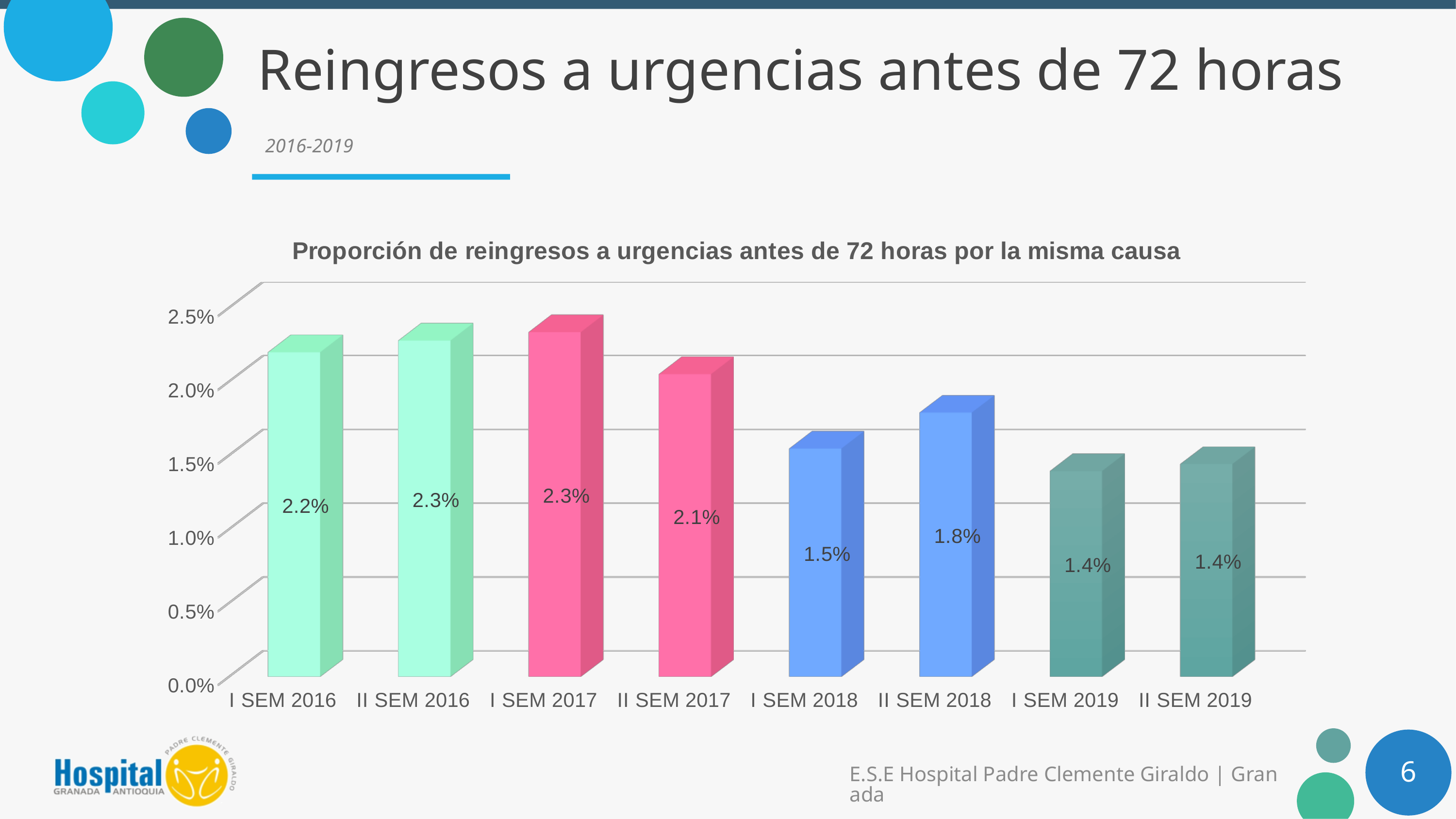
What is the value for II SEM 2018? 1.8% How many categories are shown on the x axis? 8 What is the value for I SEM 2016? 2.2% What is the difference between the values for I SEM 2017 and I SEM 2018? 0.8% What is the value for I SEM 2019? 1.4% What is the title of the chart? Proporción de reingresos a urgencias antes de 72 horas por la misma causa Do the values generally rise or fall from I SEM 2016 to II SEM 2019? fall What kind of chart is shown on the slide? bar chart Is the value for II SEM 2016 greater or less than 2.0%? greater Which category has the lowest value? I SEM 2019 and II SEM 2019 (both 1.4%) Which is larger, the value for II SEM 2018 or the value for I SEM 2018? II SEM 2018 What is the value for II SEM 2017? 2.1%